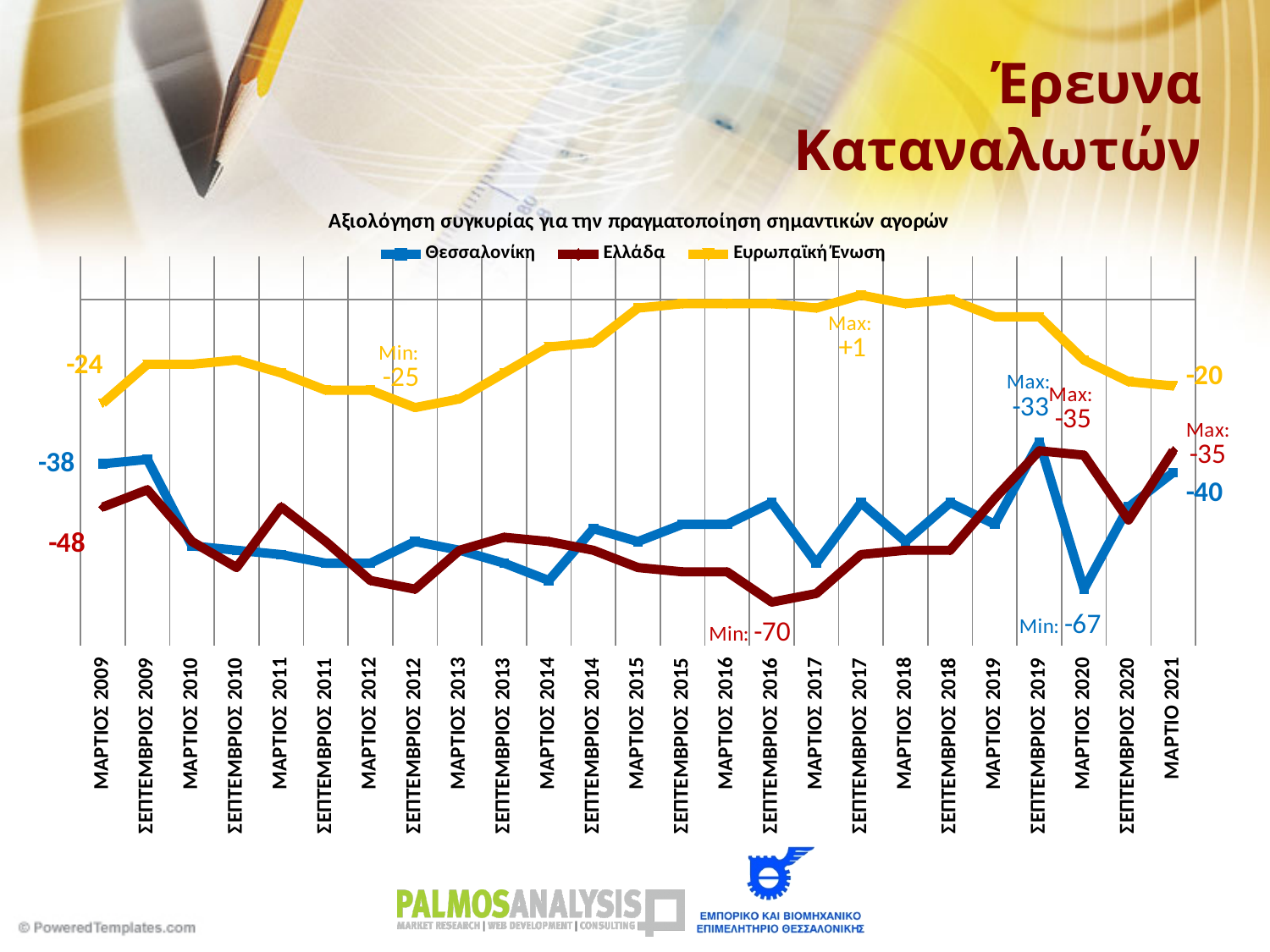
What is the minimum value reached by the Ελλάδα series? -70 What is the value for Θεσσαλονίκη in ΜΑΡΤΙΟ 2021? -40 What kind of chart is shown on the slide? line chart How many series does the legend list? 3 Which series has the higher value in ΜΑΡΤΙΟΣ 2009, Θεσσαλονίκη or Ελλάδα? Θεσσαλονίκη What is the value for Ευρωπαϊκή Ένωση in ΜΑΡΤΙΟΣ 2009? -24 What is the title of the chart? Αξιολόγηση συγκυρίας για την πραγματοποίηση σημαντικών αγορών What is the difference between the Ελλάδα value (-35) and the Θεσσαλονίκη value (-40) in ΜΑΡΤΙΟ 2021? 5 What is the minimum value reached by the Θεσσαλονίκη series? -67 What is the value for Θεσσαλονίκη in ΜΑΡΤΙΟΣ 2009? -38 What is the value for Ελλάδα in ΜΑΡΤΙΟΣ 2009? -48 What is the maximum value reached by the Ευρωπαϊκή Ένωση series? +1